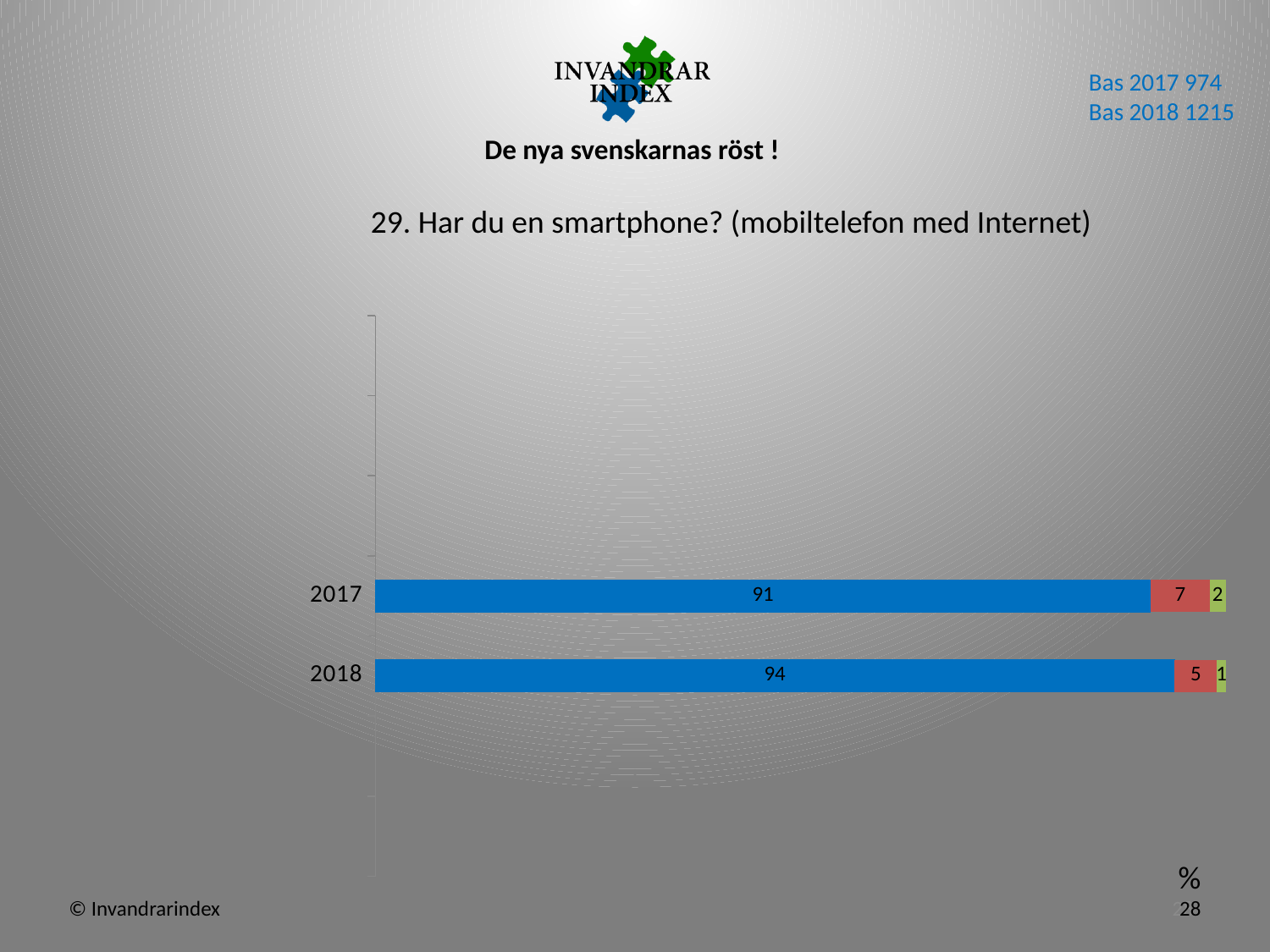
What is the value of the red segment for 2018? 5 How many years (categories) are shown in the chart? 2 What is the value of the red segment for 2017? 7 What is the value of the blue segment for 2018? 94 What kind of chart is shown on the slide? Stacked horizontal bar chart Which year has the larger blue segment, 2017 or 2018? 2018 What is the difference between the blue segment values for 2018 and 2017? 3 What is the total of the stacked bar for 2017? 100 What is the difference between the red segment values for 2017 and 2018? 2 What is the value of the blue segment for 2017? 91 What is the value of the green segment for 2018? 1 What is the title of the chart on the slide? 29. Har du en smartphone? (mobiltelefon med Internet)